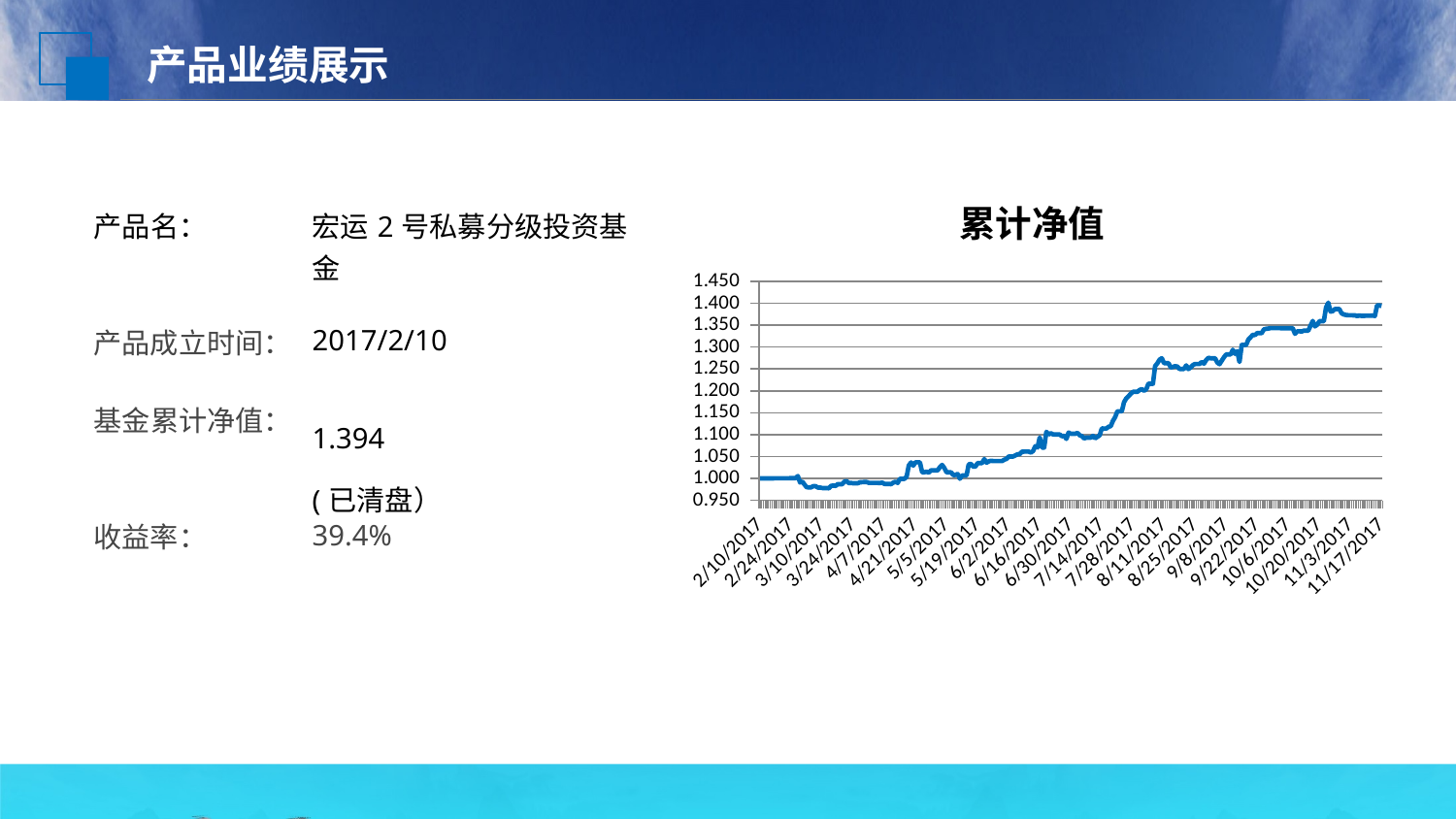
Is the value for 2/10/2017 greater or less than 1.050? less Is the value for 5/5/2017 greater or less than 1.050? less What is the highest tick shown on the vertical axis of the 累计净值 chart? 1.450 Do the values in the 累计净值 chart generally rise or fall from 2/10/2017 to 11/17/2017? rise Is the value for 11/17/2017 greater or less than 1.350? greater How many lines are plotted in the 累计净值 chart? 1 What kind of chart is shown on the slide? line chart What is the title of the chart? 累计净值 Which is larger, the value for 2/10/2017 or the value for 11/17/2017? 11/17/2017